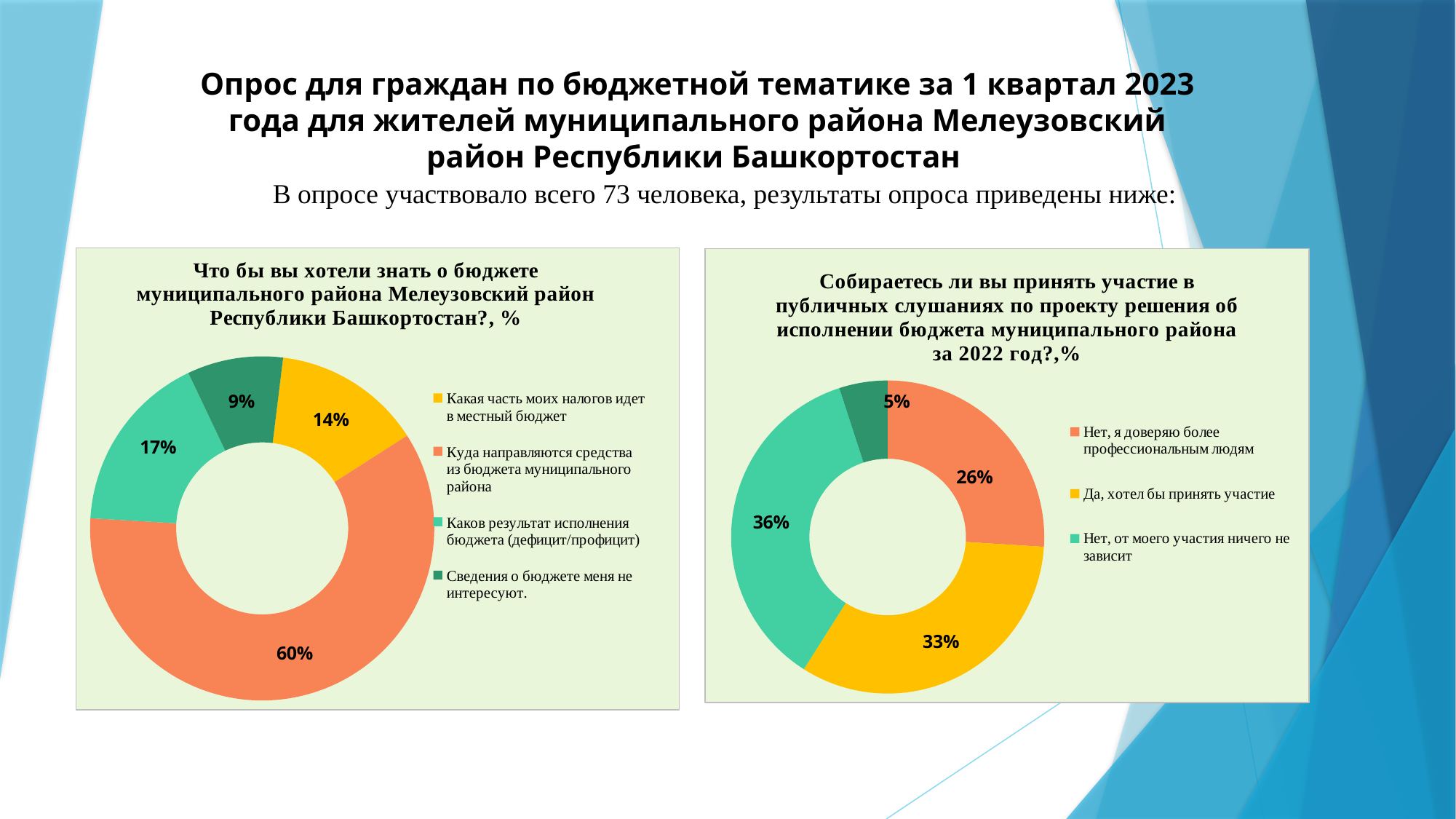
In the left chart, what is the difference between the shares for "Каков результат исполнения бюджета (дефицит/профицит)" and "Сведения о бюджете меня не интересуют."? 8% How many entries does the legend of the right chart list? 3 What type of chart is the left chart? Doughnut (pie) chart In the right chart, what percentage is shown for "Нет, от моего участия ничего не зависит"? 36% In the left chart ("Что бы вы хотели знать о бюджете..."), what percentage is shown for "Куда направляются средства из бюджета муниципального района"? 60% In the left chart, which category has the largest share? Куда направляются средства из бюджета муниципального района In the right chart ("Собираетесь ли вы принять участие в публичных слушаниях..."), what percentage is shown for "Да, хотел бы принять участие"? 33% In the right chart, which is larger: the share for "Нет, я доверяю более профессиональным людям" or the share for "Да, хотел бы принять участие"? Да, хотел бы принять участие In the left chart, which category has the smallest share? Сведения о бюджете меня не интересуют. In the right chart, what is the difference between the shares for "Нет, от моего участия ничего не зависит" and "Нет, я доверяю более профессиональным людям"? 10% How many categories does the legend of the left chart list? 4 In the left chart, what percentage is shown for "Какая часть моих налогов идет в местный бюджет"? 14%